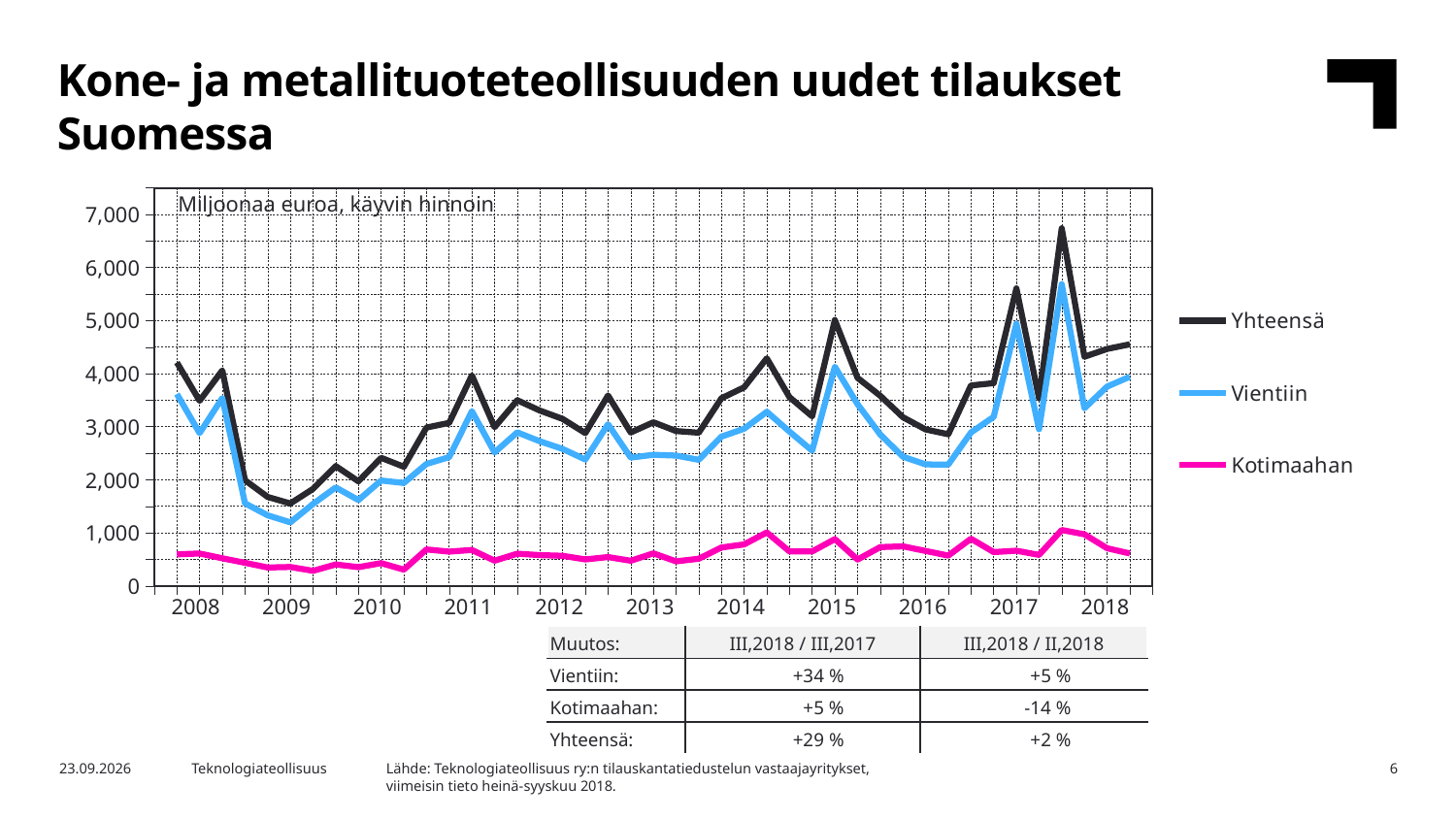
In which year does the Yhteensä line reach its highest peak? 2017 Which is larger at the 2017 peak, Vientiin or Kotimaahan? Vientiin How many years are labelled on the x axis? 11 Which series stays lowest across the whole period? Kotimaahan Is the highest peak of the Yhteensä line greater or less than 6,000? greater What kind of chart is shown on the slide? Line chart Which series reaches the highest value on the chart? Yhteensä Is the highest value of the Kotimaahan line greater or less than 2,000? less Does the Yhteensä line rise or fall from 2008 to 2009? Fall What are the three series named in the legend? Yhteensä, Vientiin, Kotimaahan How many series does the legend list? 3 What unit label is shown inside the chart area? Miljoonaa euroa, käyvin hinnoin